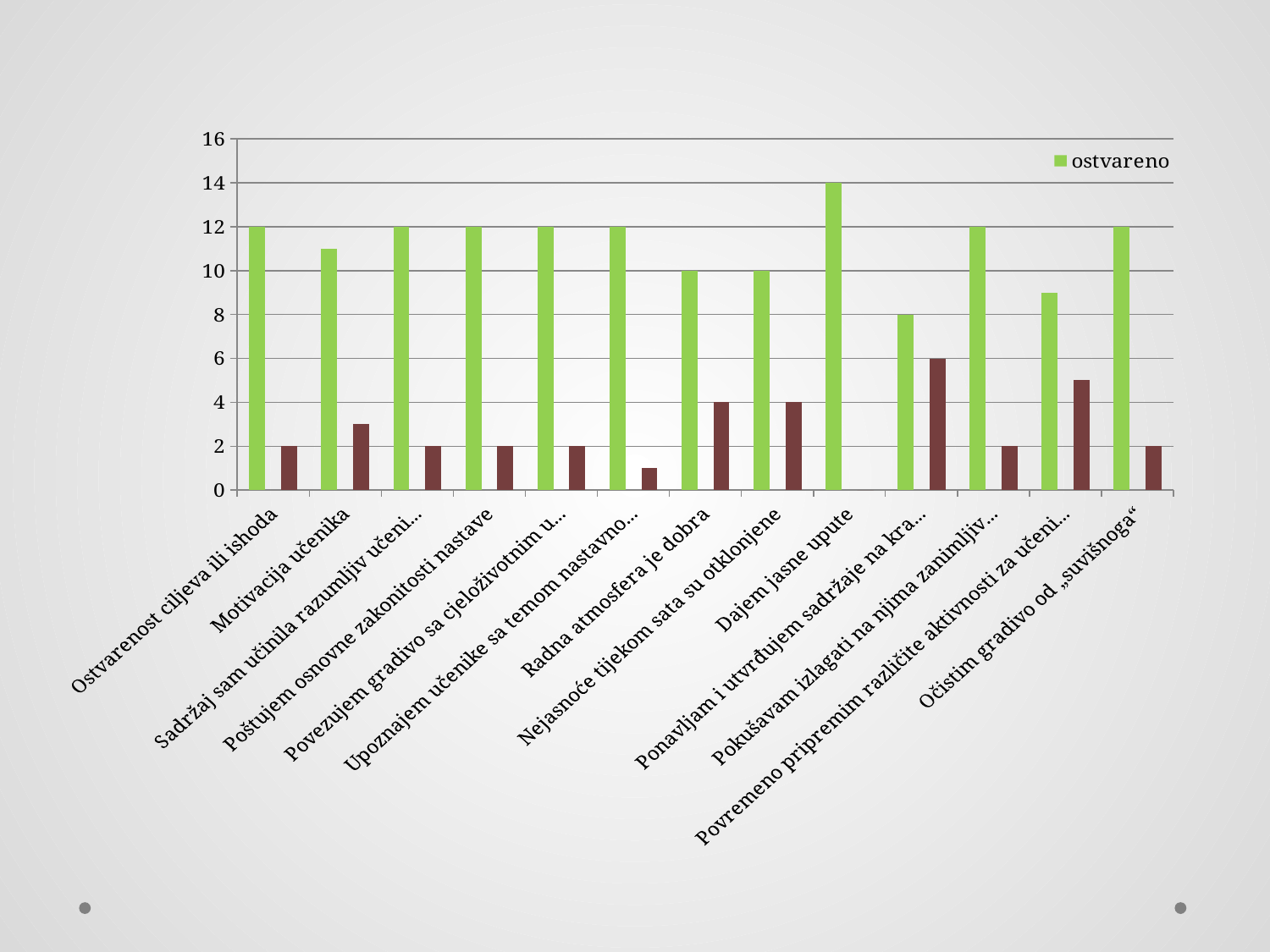
Is the green bar for 'Motivacija učenika' greater or less than 10? greater How many categories are shown along the x axis? 13 What colour are the bars of the 'ostvareno' series? green What kind of chart is shown on the slide? bar chart What is the value of the green bar for 'Dajem jasne upute'? 14 What is the difference between the green bars for 'Dajem jasne upute' and 'Radna atmosfera je dobra'? 4 Which has the larger green bar, 'Dajem jasne upute' or 'Radna atmosfera je dobra'? Dajem jasne upute How many series does the legend list? 1 Which category has the highest green bar? Dajem jasne upute What is the value of the dark red bar for 'Radna atmosfera je dobra'? 4 What is the value of the green bar for 'Ostvarenost ciljeva ili ishoda'? 12 What is the name of the series listed in the legend? ostvareno